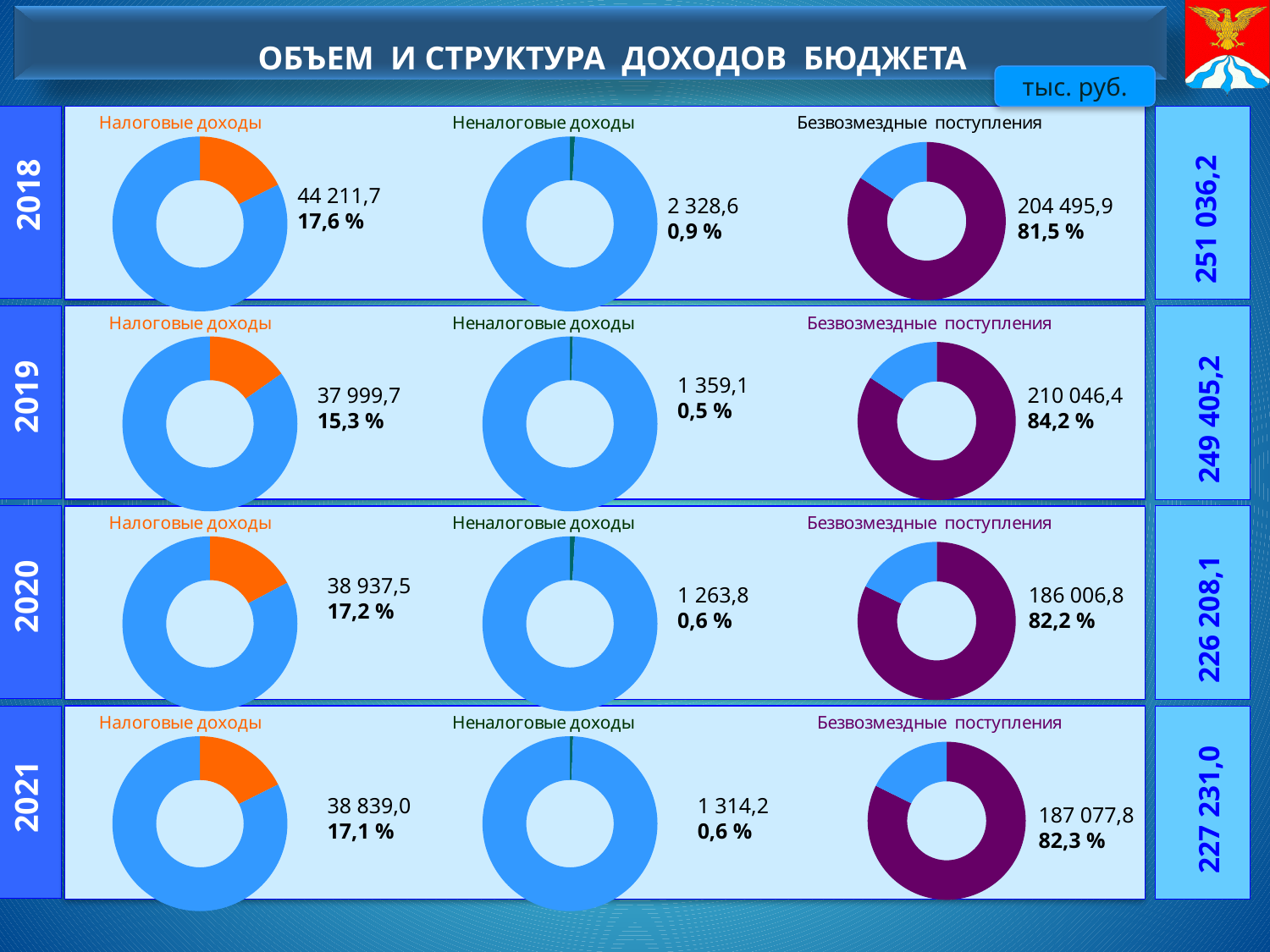
In the 2021 row, what share does the 'Неналоговые доходы' donut chart show? 0,6 % What type of chart is used for each of the twelve charts on the slide? Donut (pie) chart In the 2018 row, what share does the 'Безвозмездные поступления' donut chart show? 81,5 % How many donut charts are shown on the slide in total? 12 Across the 2018 row, which of the three donut charts shows the lowest value? Неналоговые доходы In the 2018 row, what value is shown on the 'Налоговые доходы' donut chart? 44 211,7 Which is larger: the 'Налоговые доходы' value in the 2018 row or in the 2019 row? 2018 In the 2020 row, what value is shown on the 'Безвозмездные поступления' donut chart? 186 006,8 Across the 2021 row, which of the three donut charts shows the highest value? Безвозмездные поступления In the 2019 row, what share does the 'Налоговые доходы' donut chart show? 15,3 % What is the difference between the 'Налоговые доходы' value in the 2020 row and in the 2021 row? 98,5 In the 2019 row, what value is shown on the 'Неналоговые доходы' donut chart? 1 359,1